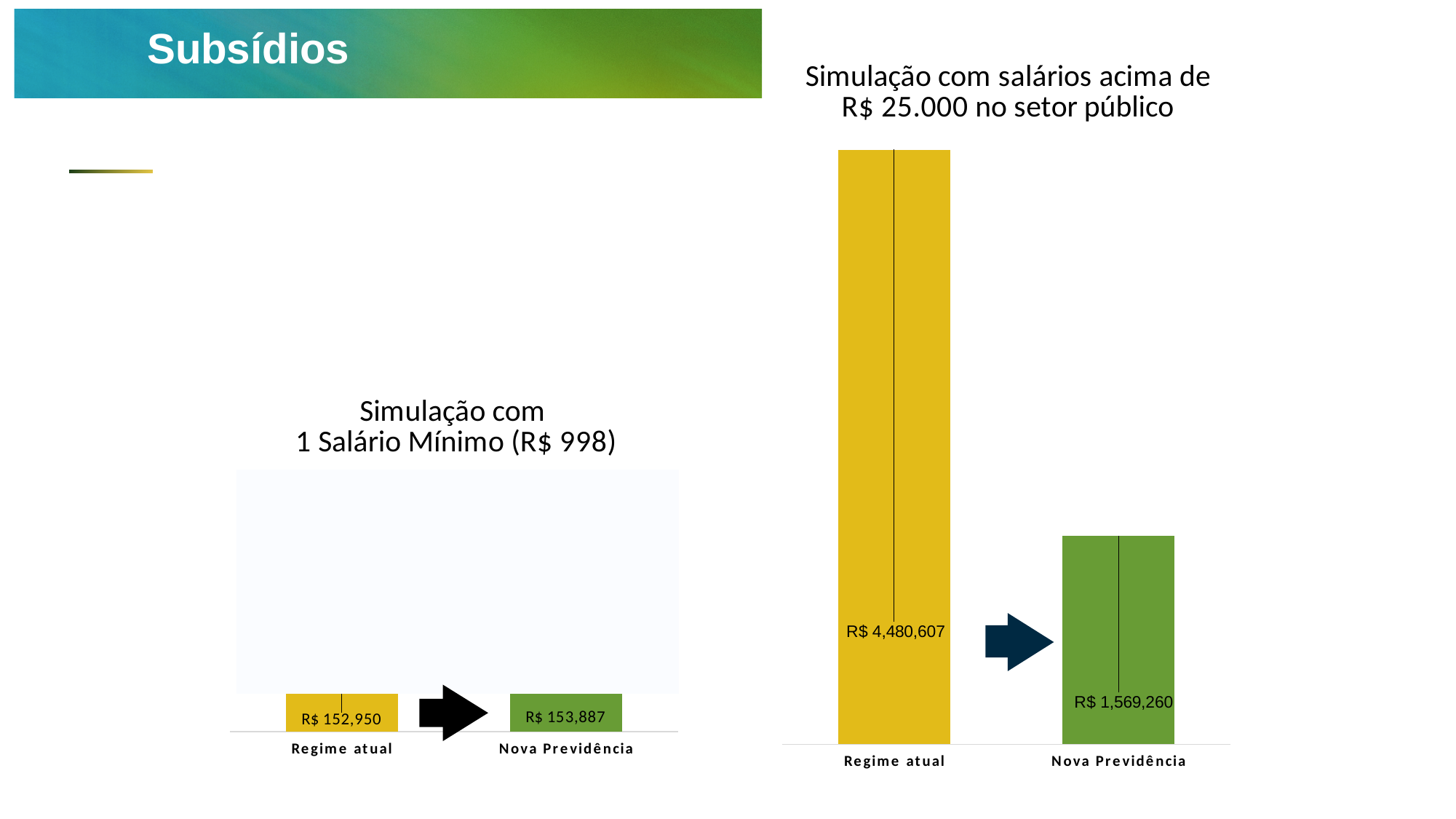
In the chart titled 'Simulação com 1 Salário Mínimo (R$ 998)', what is the value for Regime atual? R$ 152,950 In the chart on the left, which is larger according to the data labels: Regime atual or Nova Previdência? Nova Previdência What is the title of the chart on the right? Simulação com salários acima de R$ 25.000 no setor público In the chart titled 'Simulação com salários acima de R$ 25.000 no setor público', what is the value for Nova Previdência? R$ 1,569,260 In the chart titled 'Simulação com 1 Salário Mínimo (R$ 998)', what is the value for Nova Previdência? R$ 153,887 In the chart on the right, which category has the lowest value? Nova Previdência In the chart on the right, what is the difference between the Regime atual and Nova Previdência values? R$ 2,911,347 In the chart on the left, what is the difference between the Nova Previdência and Regime atual values? R$ 937 In the chart titled 'Simulação com salários acima de R$ 25.000 no setor público', what is the value for Regime atual? R$ 4,480,607 What kind of chart is the one on the left? Bar chart How many categories are shown in the chart on the right? 2 In the chart on the right, which category has the highest value? Regime atual